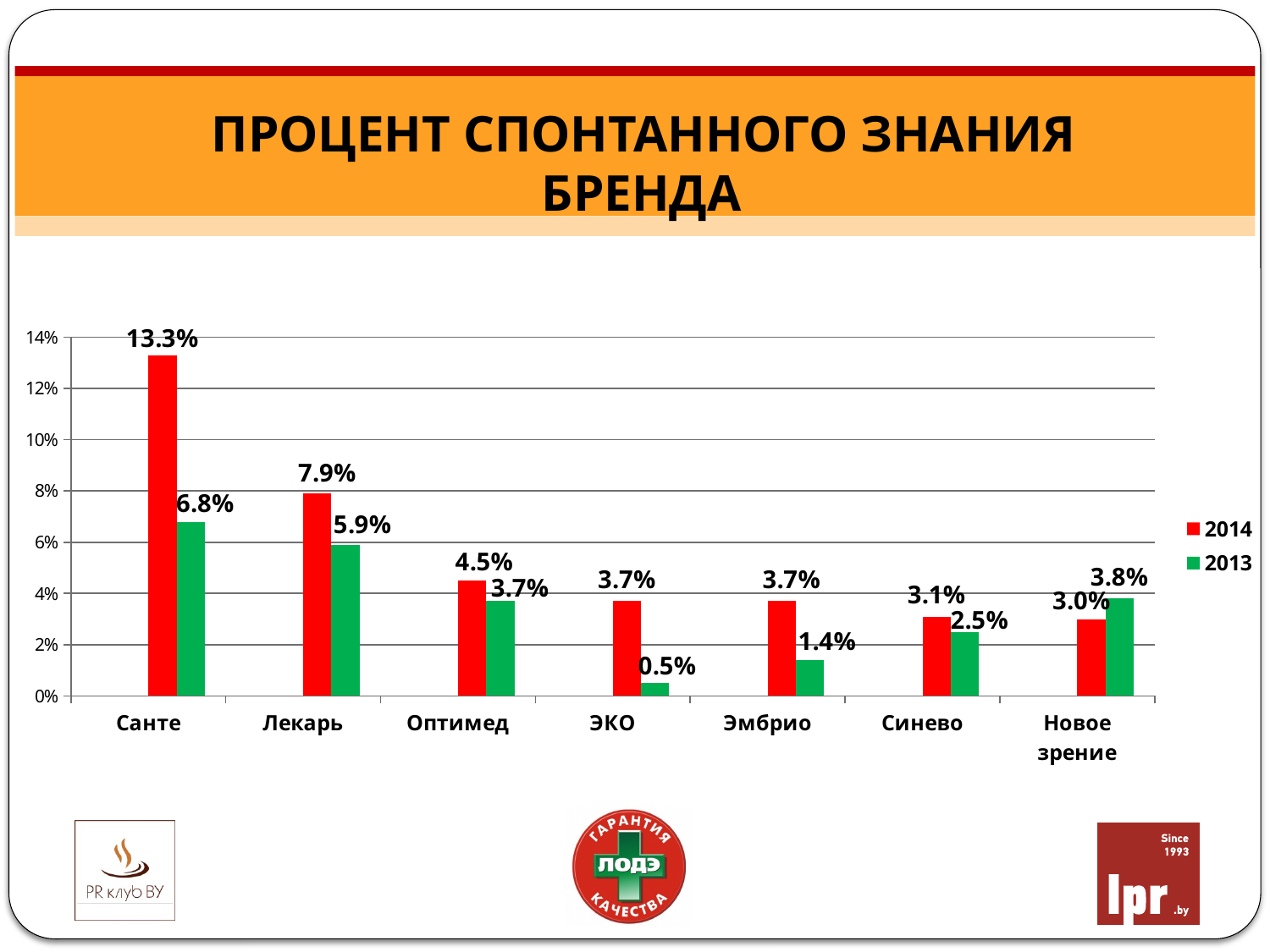
Which is larger for Новое зрение, the 2014 value or the 2013 value? 2013 What is the 2013 value for ЭКО? 0.5% What kind of chart is shown on the slide? Bar chart What is the difference between the 2014 and 2013 values for Эмбрио? 2.3% Which category has the lowest 2013 value? ЭКО Which colour represents the 2013 series in the legend? Green What is the difference between the 2014 and 2013 values for Санте? 6.5% How many categories are shown on the x axis? 7 How many series does the legend list? 2 What is the 2014 value for Санте? 13.3% What is the 2013 value for Новое зрение? 3.8% Which category has the highest 2014 value? Санте